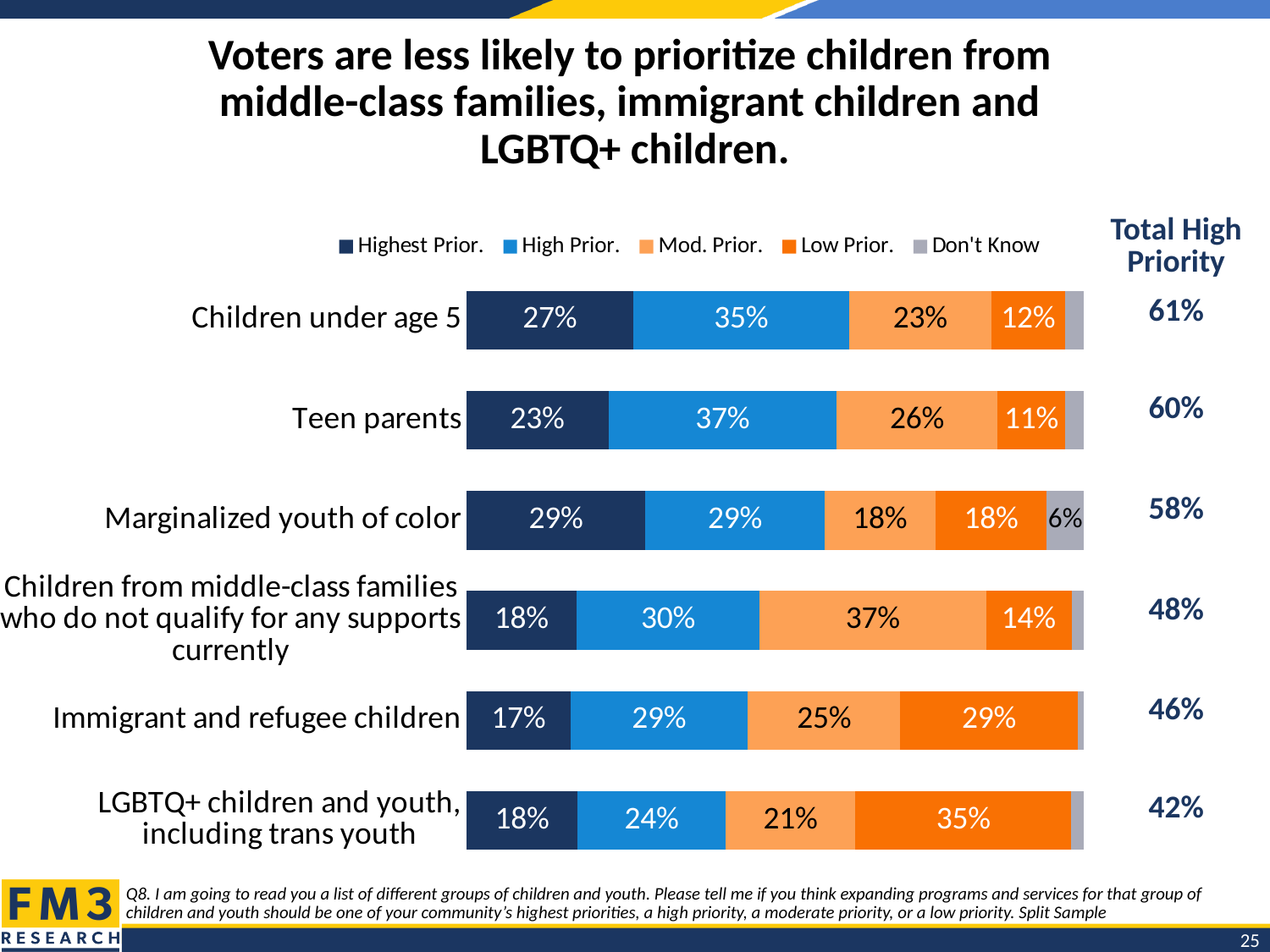
What is the Moderate Priority value for 'Children from middle-class families who do not qualify for any supports currently'? 37% What percentage of voters rated 'Children under age 5' as the Highest Priority? 27% What is the Total High Priority value for 'Teen parents'? 60% What kind of chart is shown on the slide? Stacked bar chart What is the Don't Know value shown for 'Marginalized youth of color'? 6% What is the difference in Total High Priority between 'Children under age 5' and 'LGBTQ+ children and youth, including trans youth'? 19 percentage points Which has a larger Low Priority value: 'Immigrant and refugee children' or 'Marginalized youth of color'? Immigrant and refugee children How many series does the legend list? 5 How many groups of children and youth are shown in the chart? 6 What is the Low Priority value for 'LGBTQ+ children and youth, including trans youth'? 35% Which group has the lowest Total High Priority value? LGBTQ+ children and youth, including trans youth Which group has the highest Total High Priority value? Children under age 5